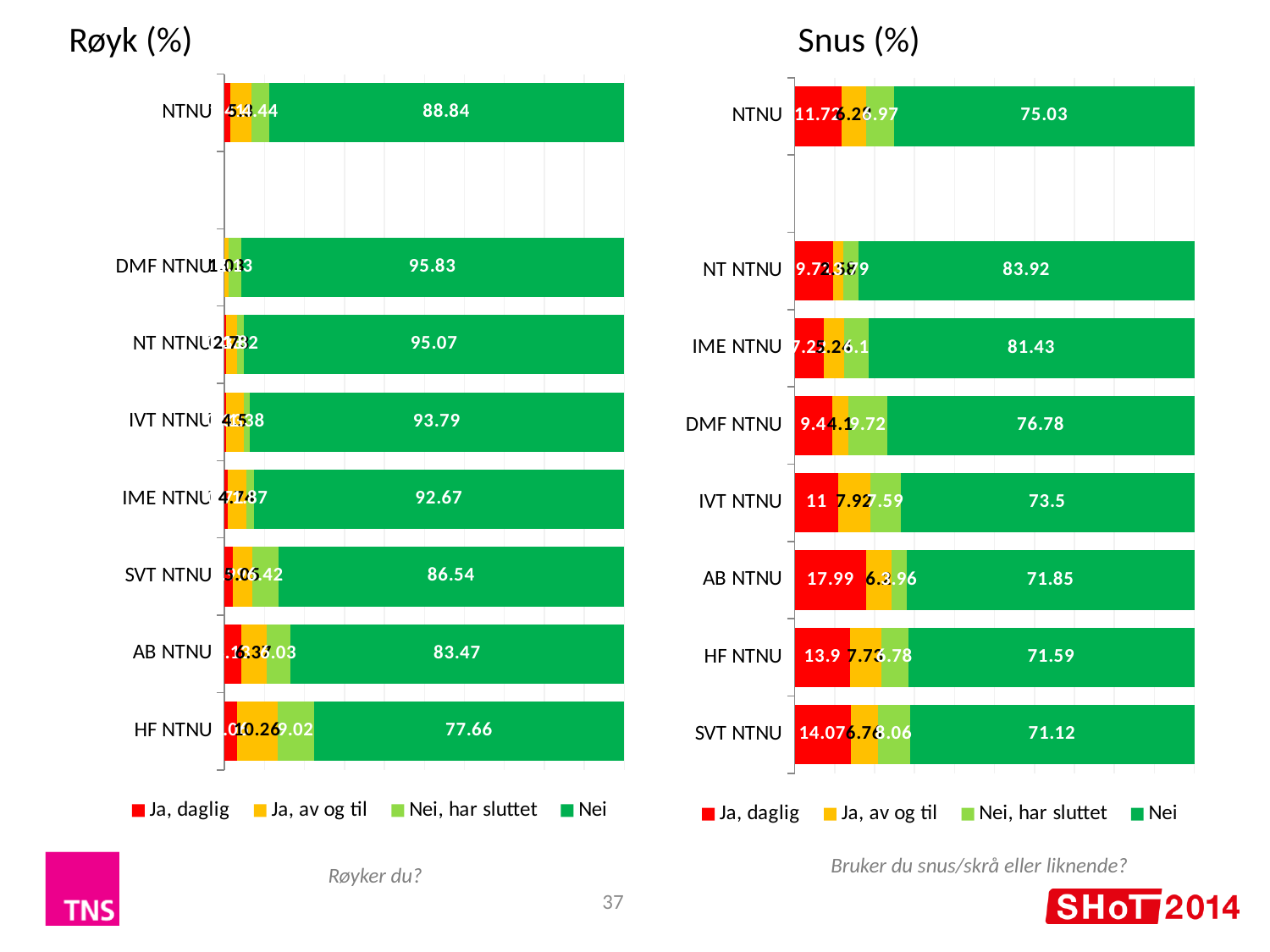
In the Snus (%) chart, which has the larger "Nei" value, IVT NTNU or DMF NTNU? DMF NTNU In the Snus (%) chart, which category has the highest "Ja, daglig" value? AB NTNU In the Røyk (%) chart, what is the difference between the "Nei" values for DMF NTNU and HF NTNU? 18.17 In the Røyk (%) chart, which category has the lowest "Nei" value? HF NTNU In the Røyk (%) chart, which category has the highest "Nei" value? DMF NTNU How many categories are shown in the Røyk (%) chart? 8 In the Røyk (%) chart, what is the value of the "Nei" segment for NTNU? 88.84 What type of chart is the Røyk (%) chart? Stacked bar chart In the Snus (%) chart, what is the "Nei" value for NT NTNU? 83.92 In the Snus (%) chart, what is the "Ja, daglig" value for AB NTNU? 17.99 In the Snus (%) chart, what is the difference between the "Nei" values for NT NTNU and SVT NTNU? 12.8 How many series does the legend of the Snus (%) chart list? 4